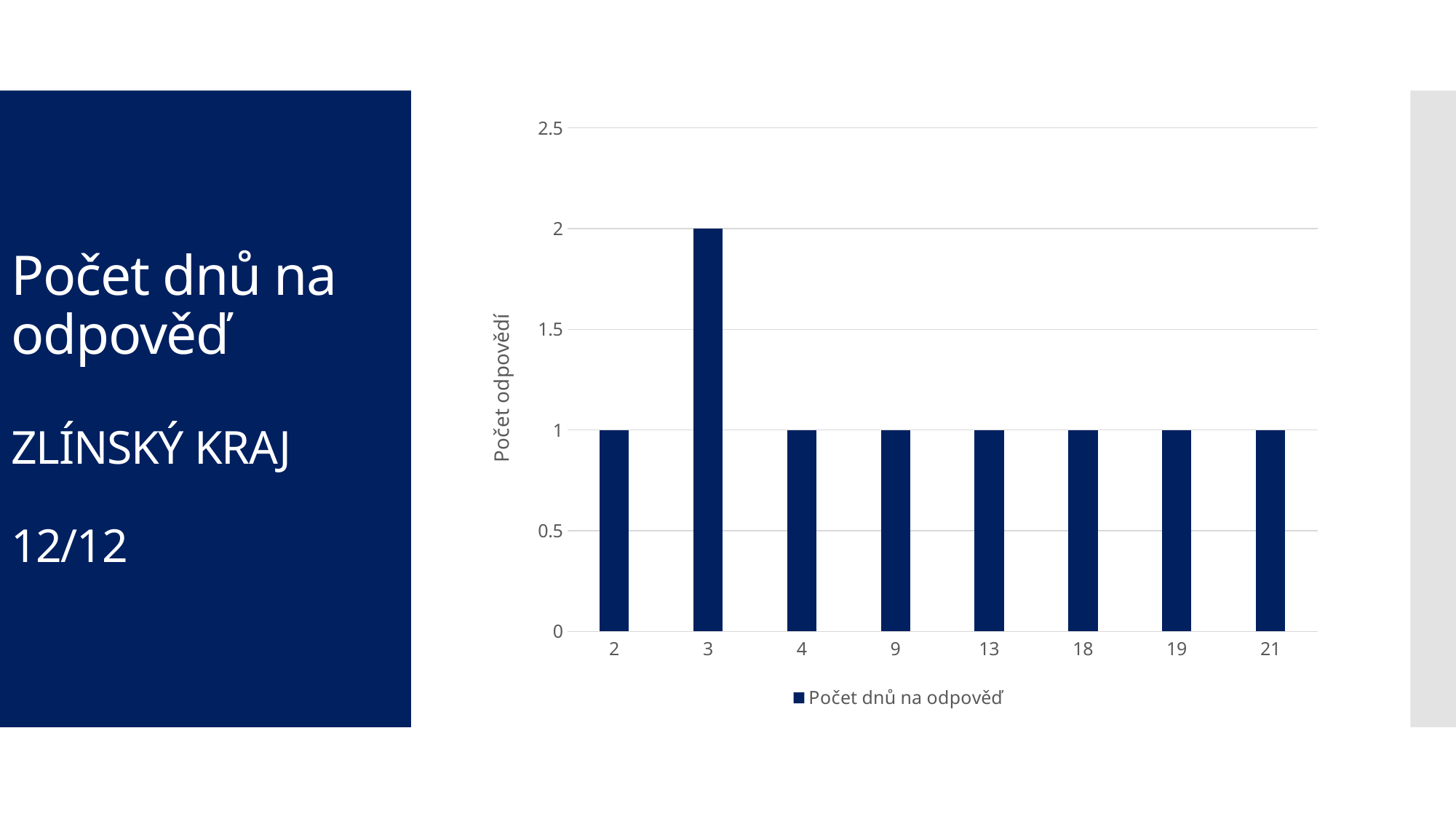
What is the difference between the values for category 3 and category 13? 1 How many categories are shown on the x axis of the chart? 8 What is the value for category 2 in the chart? 1 What is the value for category 21 in the chart? 1 What is the label of the vertical axis of the chart? Počet odpovědí Which category has the highest value in the chart? 3 How many series does the chart legend list? 1 What series name is shown in the chart legend? Počet dnů na odpověď What is the value for category 3 in the chart? 2 Which is larger, the value for category 3 or the value for category 18? 3 What kind of chart is shown on the slide? bar chart Is the value for category 3 greater or less than 1.5? greater